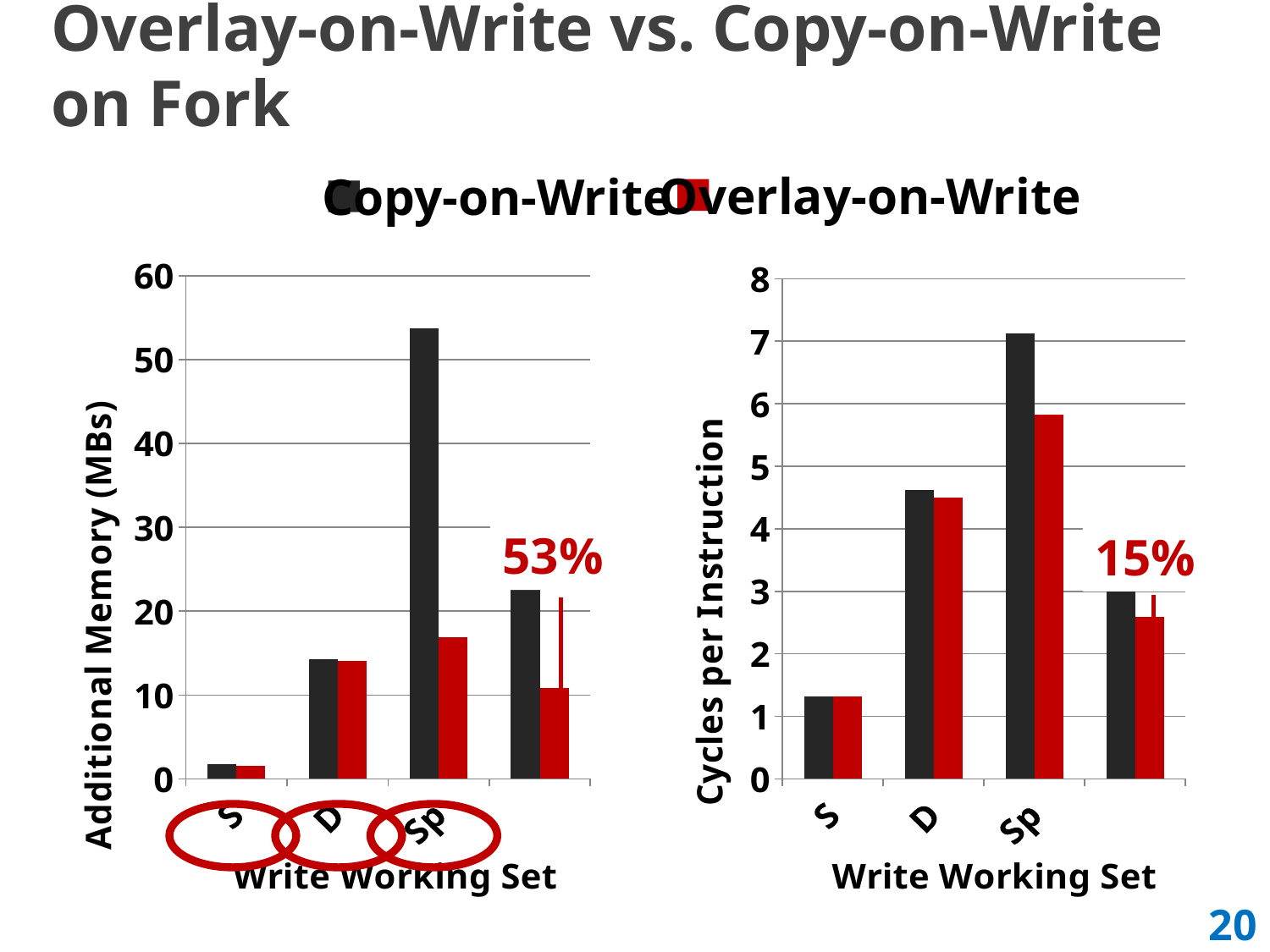
In the right chart (Cycles per Instruction), which labeled write working set has the highest Copy-on-Write value? Sp How many series does the legend list? 2 In the right chart (Cycles per Instruction), is the Copy-on-Write value for Sp greater or less than 6? greater What percentage is annotated in red on the left chart (Additional Memory)? 53% In the left chart (Additional Memory), is the Overlay-on-Write value for Sp greater or less than 20? less In the left chart (Additional Memory), is the Copy-on-Write value for Sp greater or less than 50? greater In the left chart (Additional Memory), which labeled write working set has the lowest Overlay-on-Write value? S What kind of chart is the left chart (Additional Memory)? bar chart In the left chart (Additional Memory), which labeled write working set has the highest Copy-on-Write value? Sp In the left chart (Additional Memory), for Sp, which is larger: Copy-on-Write or Overlay-on-Write? Copy-on-Write What are the two series named in the legend? Copy-on-Write and Overlay-on-Write